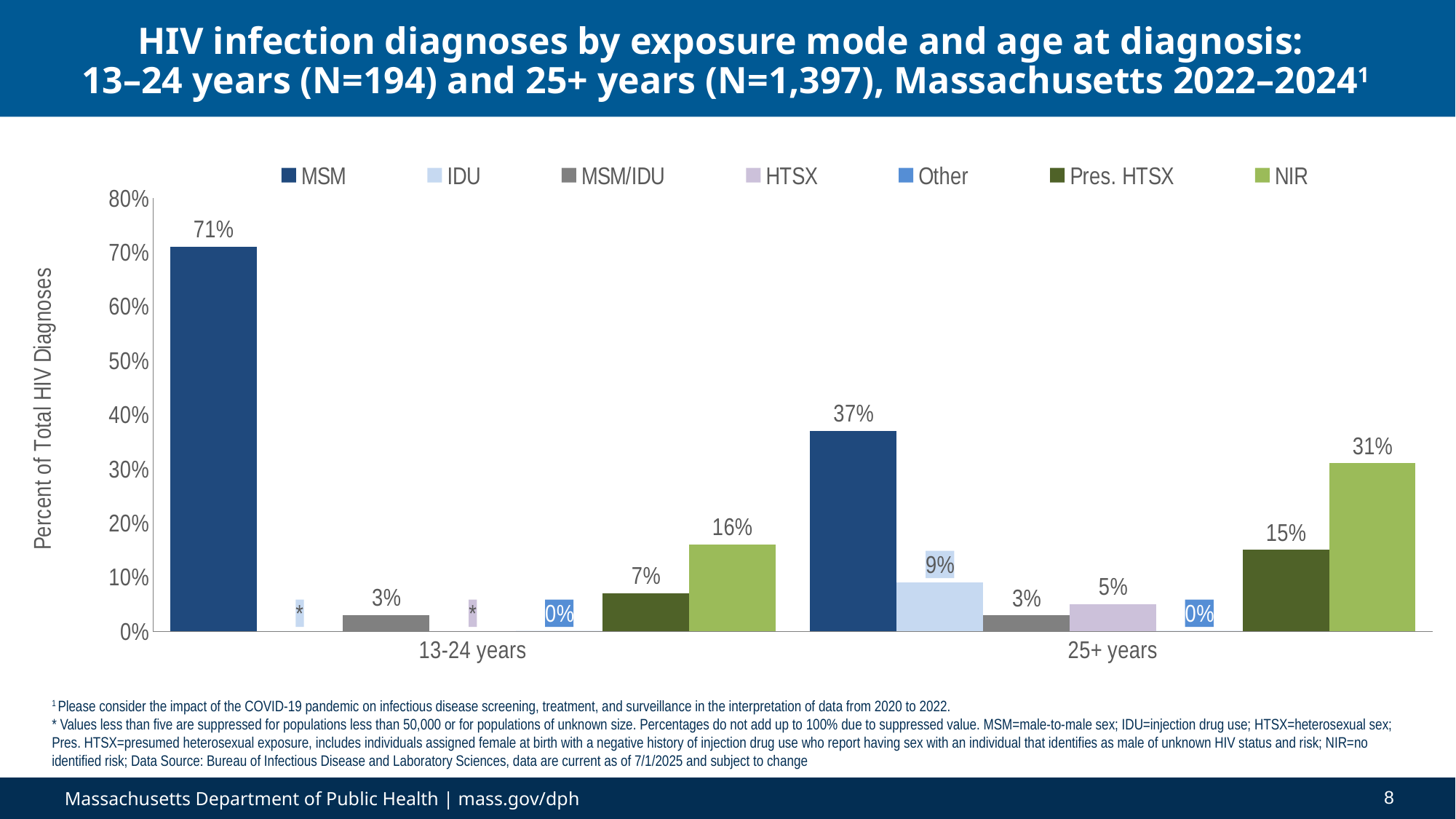
What is the label of the vertical axis? Percent of Total HIV Diagnoses Which is larger: the Pres. HTSX value for 25+ years or the NIR value for 13-24 years? NIR value for 13-24 years What is the value for IDU in the 25+ years group? 9% What percentage of HIV diagnoses among 25+ years were attributed to NIR? 31% What is the difference between the NIR percentage for 25+ years and for 13-24 years? 15% Which exposure mode has the highest percentage in the 13-24 years group? MSM What percentage of HIV diagnoses among 13-24 years were attributed to MSM? 71% How many series does the legend list? 7 What is the value for Pres. HTSX in the 13-24 years group? 7% Which exposure mode has the highest percentage in the 25+ years group? MSM What kind of chart is shown on the slide? Bar chart What is the difference between the MSM percentage for 13-24 years and for 25+ years? 34%